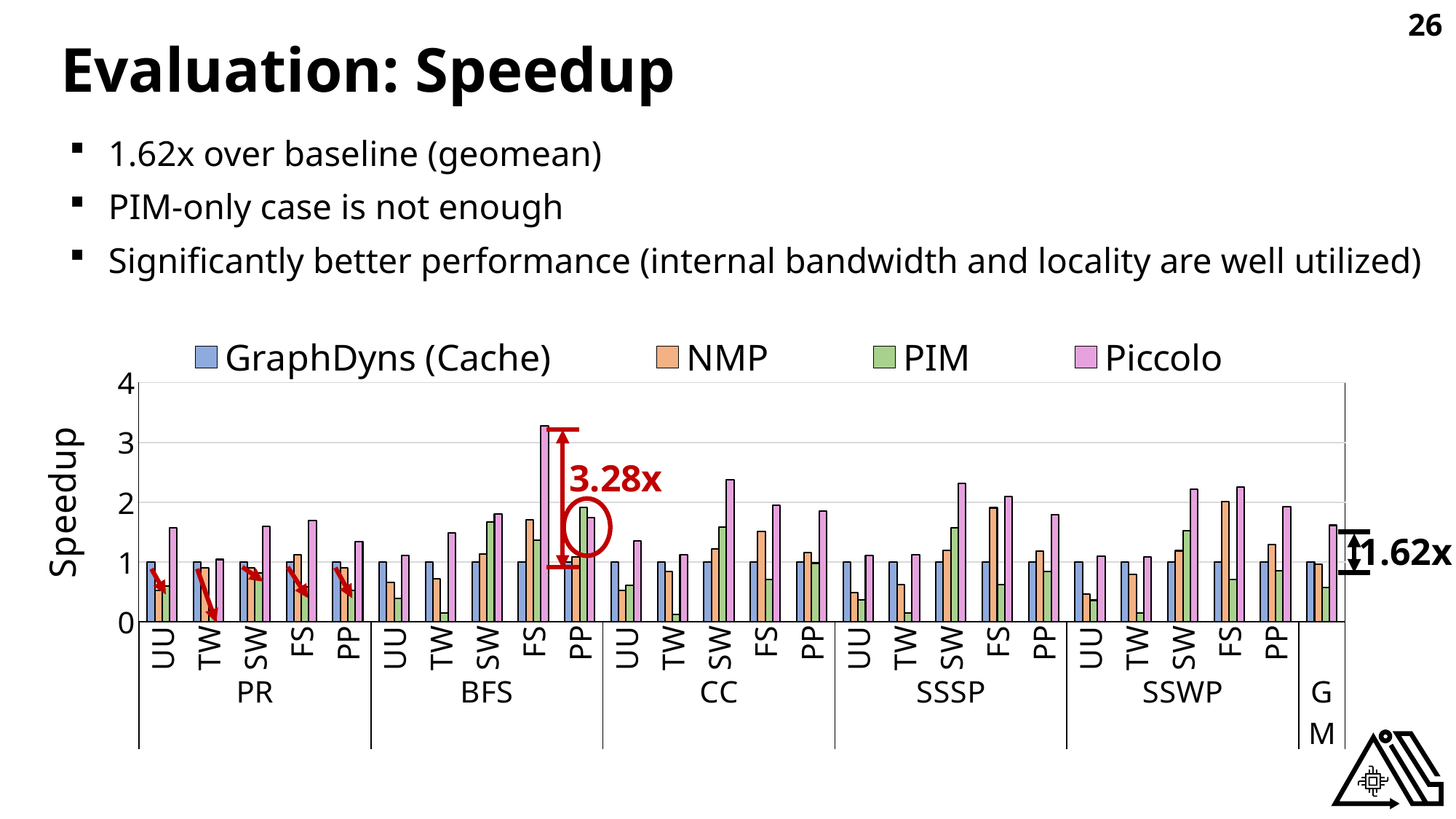
What kind of chart is shown on the slide? bar chart For the FS input of SSWP, which is larger: NMP or PIM? NMP What is the label on the y-axis of the chart? Speedup How many series does the chart legend list? 4 For the FS input of BFS, which series has the lowest speedup? GraphDyns (Cache) For the FS input of BFS, which series has the highest speedup? Piccolo What speedup is annotated for Piccolo on the FS input of BFS? 3.28x What is the first entry in the chart legend? GraphDyns (Cache) How many bar groups (x-axis categories) are plotted in the chart, including GM? 26 What speedup is annotated for Piccolo at the GM (geomean) group? 1.62x Is the PIM value for the TW input of BFS greater or less than 1? less Is the Piccolo value for the SW input of CC greater or less than 2? greater